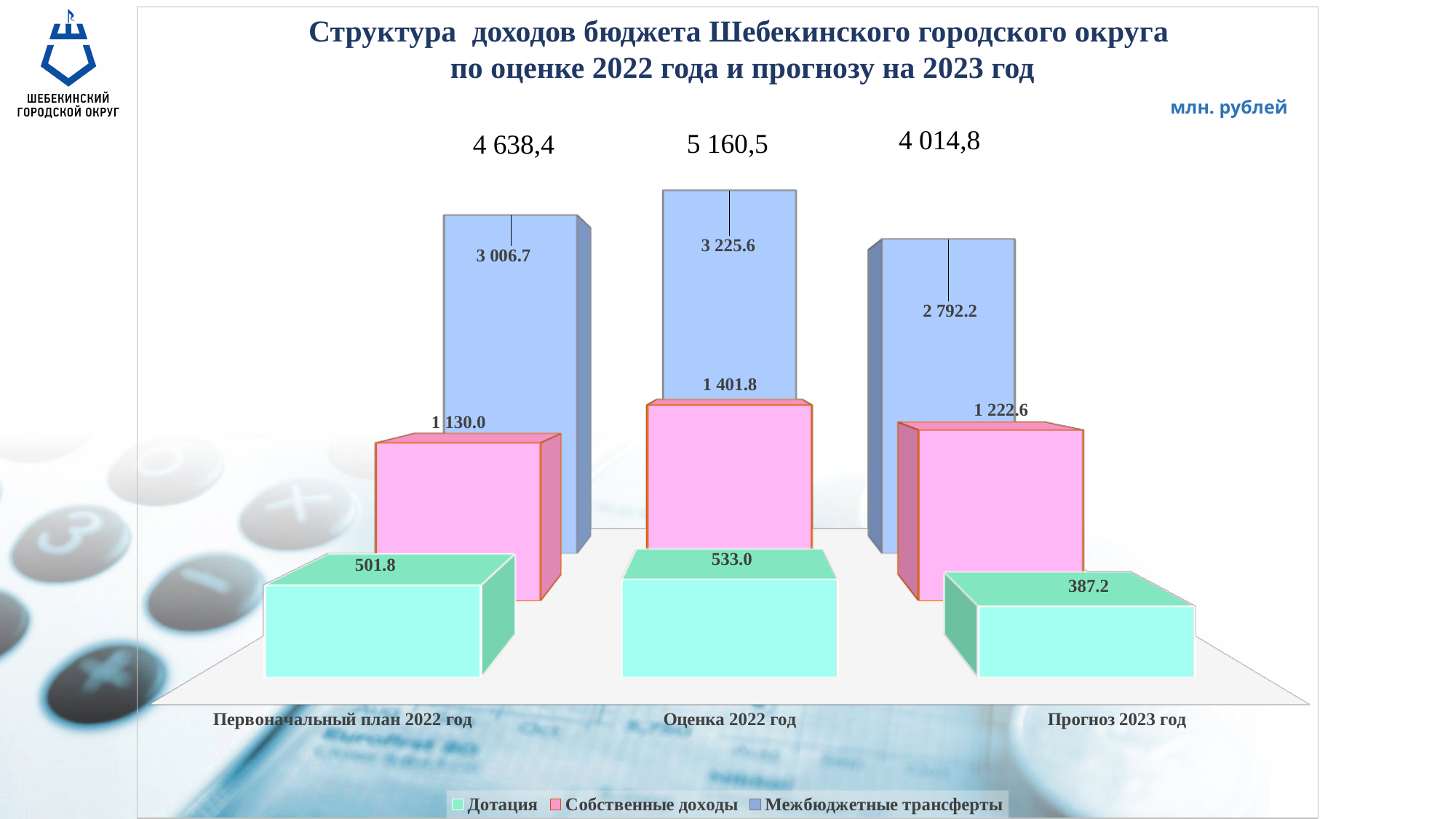
Which is larger: Межбюджетные трансферты for Первоначальный план 2022 год or for Прогноз 2023 год? Первоначальный план 2022 год What unit is indicated in the top right corner of the chart? млн. рублей What kind of chart is shown on the slide? bar chart What is the value of Межбюджетные трансферты for Оценка 2022 год? 3 225.6 Which category has the highest value for Межбюджетные трансферты? Оценка 2022 год How many series does the legend list? 3 What is the value of Дотация for Прогноз 2023 год? 387.2 Which category has the lowest value for Дотация? Прогноз 2023 год What is the difference between Собственные доходы for Оценка 2022 год and for Первоначальный план 2022 год? 271.8 What total is shown above the bars for Оценка 2022 год? 5 160,5 What is the value of Собственные доходы for Первоначальный план 2022 год? 1 130.0 How many categories are shown on the x axis? 3